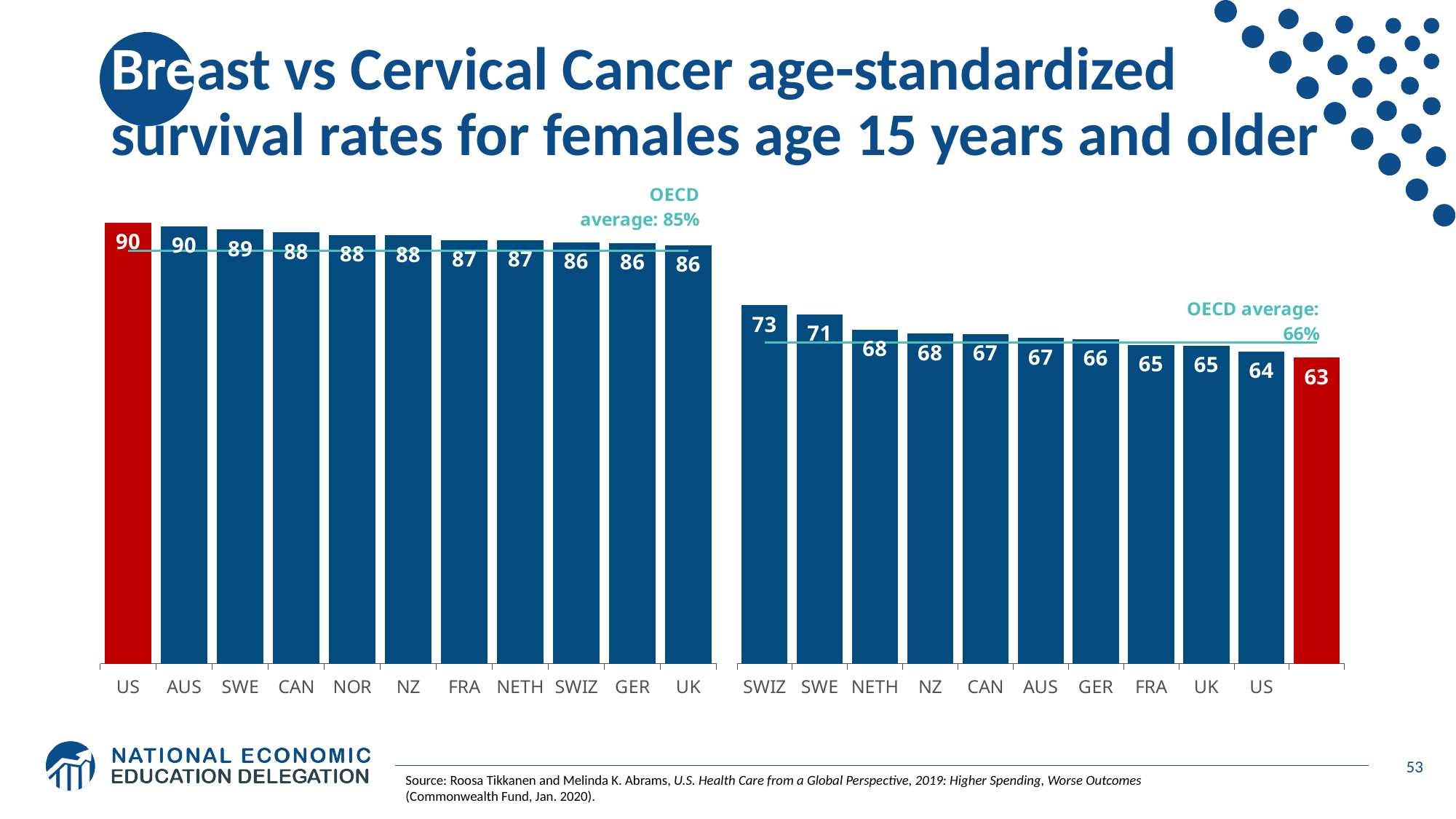
What is the breast cancer survival rate shown for the UK? 86 What is the cervical cancer survival rate shown for SWIZ? 73 What is the difference between Canada's breast cancer survival rate and its cervical cancer survival rate? 21 What is the difference between Sweden's breast cancer survival rate and its cervical cancer survival rate? 18 For France, which is higher: the breast cancer survival rate or the cervical cancer survival rate? Breast cancer survival rate What is the cervical cancer survival rate shown for GER? 66 What kind of chart is shown on the slide? Bar chart What is the OECD average shown for breast cancer survival rates? 85% Do the cervical cancer survival rates rise or fall from left to right across the bars? Fall Which country has the highest cervical cancer survival rate in the chart? SWIZ How many countries are shown in the breast cancer group of bars? 11 What is the breast cancer survival rate shown for SWE? 89